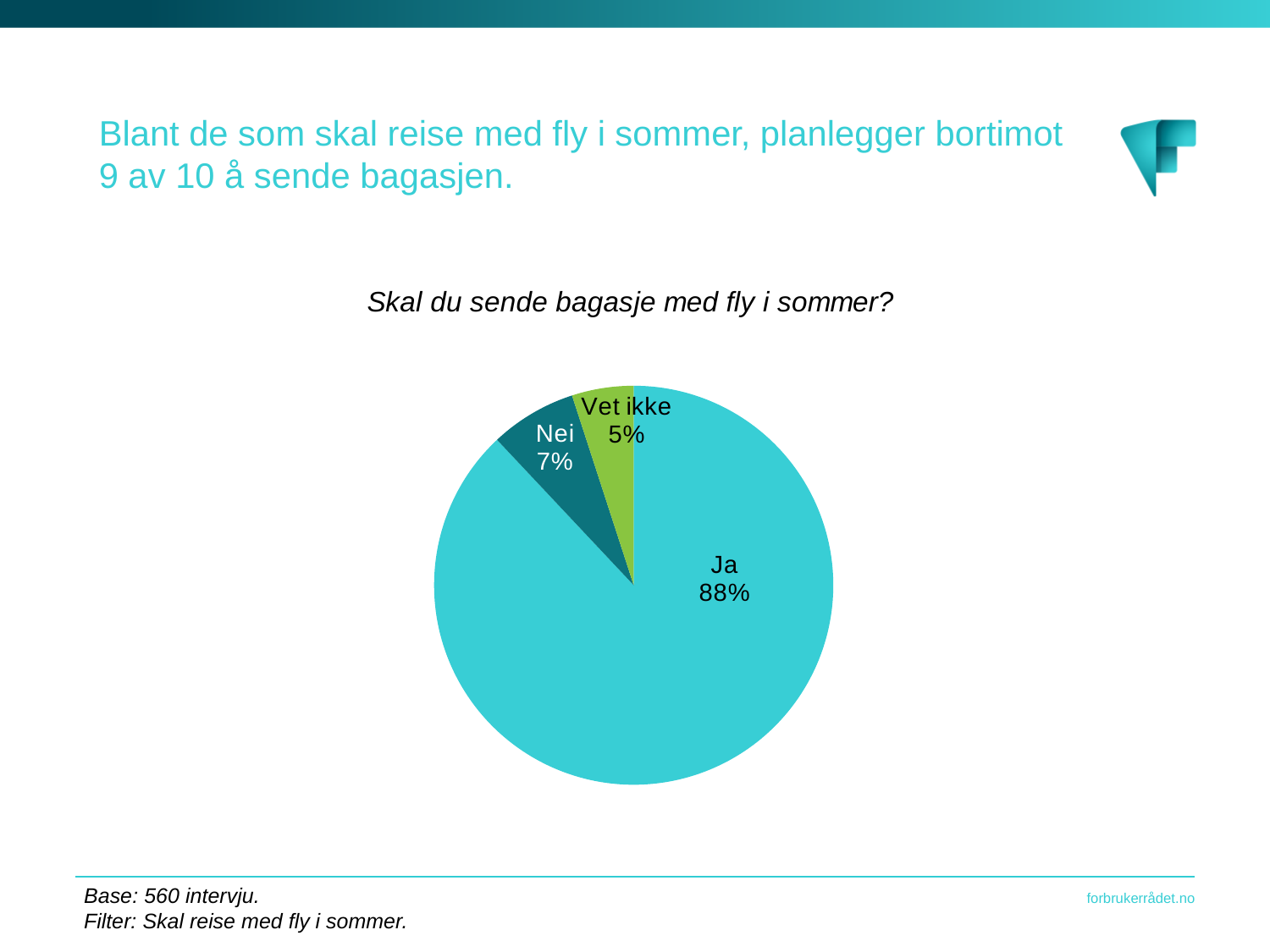
Which is larger, the share for "Nei" or the share for "Vet ikke"? Nei How many slices does the pie chart have? 3 What percentage of respondents answered "Ja"? 88% What is the difference in percentage points between "Ja" and "Nei"? 81 What kind of chart is shown on the slide? pie chart Which slice of the pie is the largest? Ja What is the difference in percentage points between "Nei" and "Vet ikke"? 2 What percentage of respondents answered "Vet ikke"? 5% What is the chart's title? Skal du sende bagasje med fly i sommer? Which slice of the pie is the smallest? Vet ikke What percentage of respondents answered "Nei"? 7% What colour is the "Vet ikke" slice? green